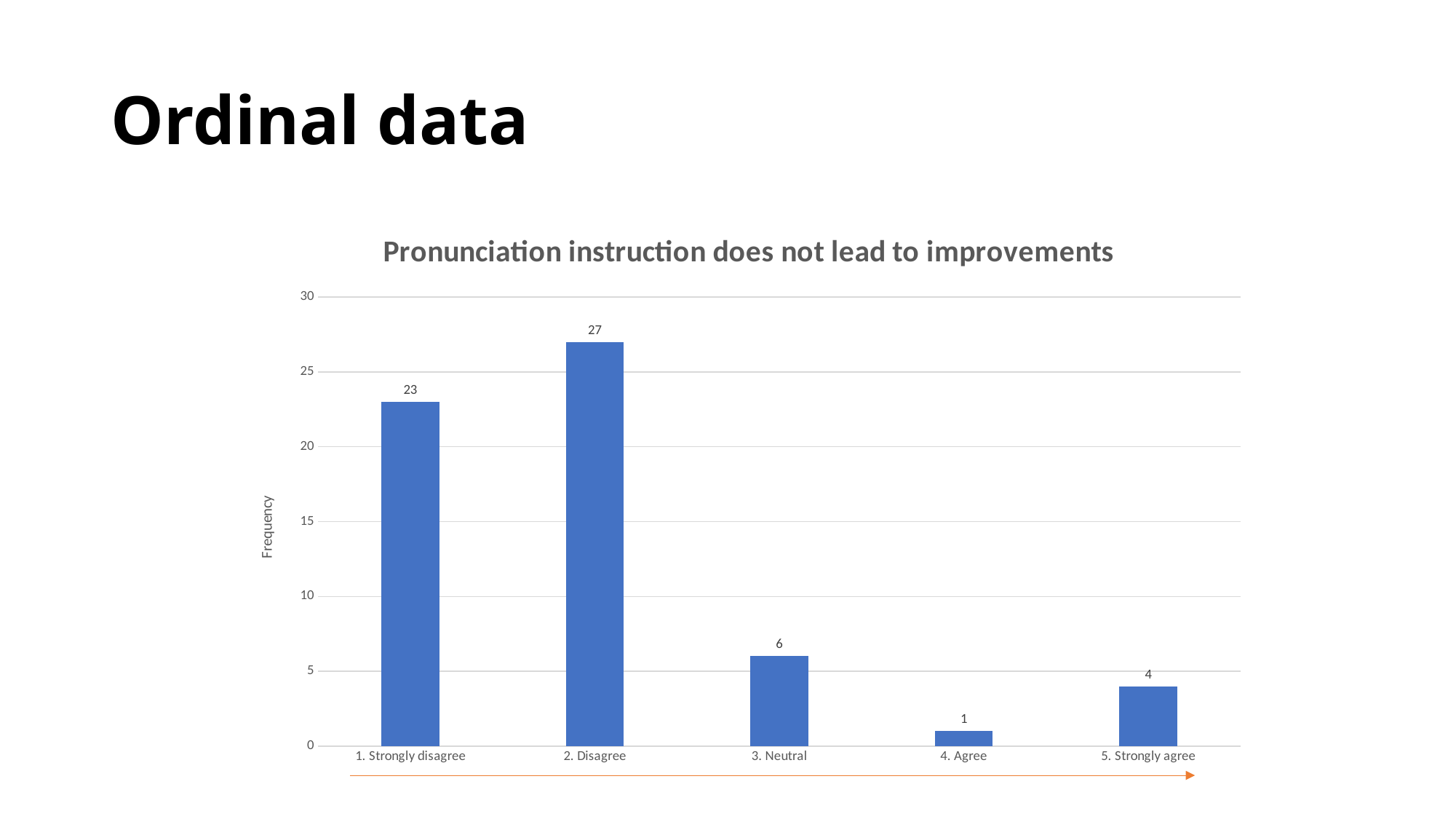
What is the title of the chart? Pronunciation instruction does not lead to improvements What is the frequency for '1. Strongly disagree'? 23 Which category has the lowest frequency? 4. Agree How many categories are shown on the x axis? 5 What is the frequency for '3. Neutral'? 6 Which has a higher frequency, '3. Neutral' or '5. Strongly agree'? 3. Neutral Is the value for '1. Strongly disagree' greater or less than 20? greater Which category has the highest frequency? 2. Disagree What is the difference in frequency between '2. Disagree' and '1. Strongly disagree'? 4 What is the frequency for '2. Disagree'? 27 What is the frequency for '5. Strongly agree'? 4 What kind of chart is shown on the slide? Bar chart